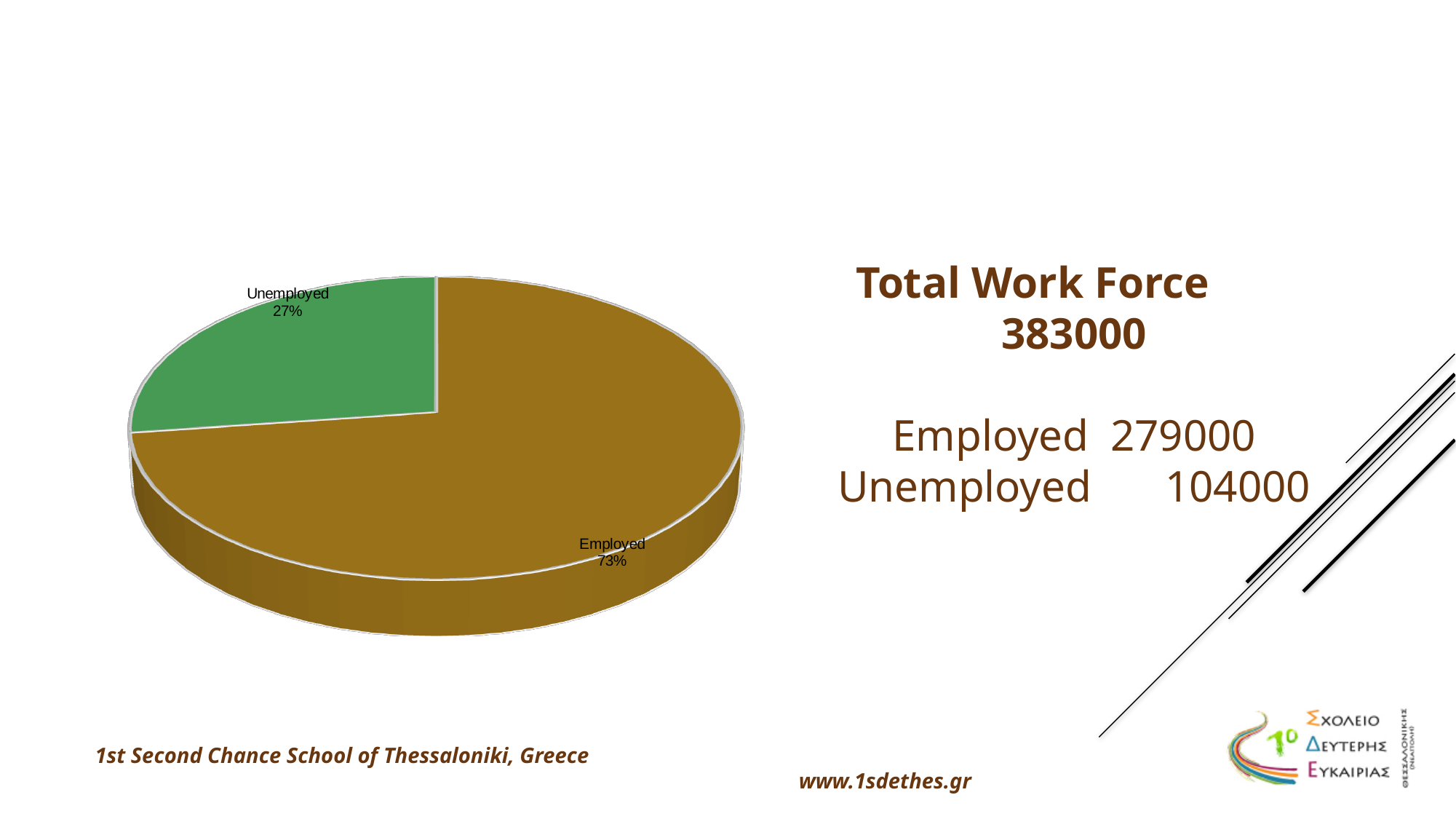
Which slice of the pie is the largest? Employed What is the difference in percentage points between the Employed and Unemployed slices? 46 How many slices does the pie chart have? 2 What percentage of the pie is labelled Employed? 73% What percentage of the pie is labelled Unemployed? 27% Which slice of the pie is the smallest? Unemployed What type of chart is shown on the slide? pie chart Is the Unemployed share of the pie greater or less than 50%? less What colour is the Unemployed slice of the pie? green What colour is the Employed slice of the pie? brown Which slice is larger, Employed or Unemployed? Employed